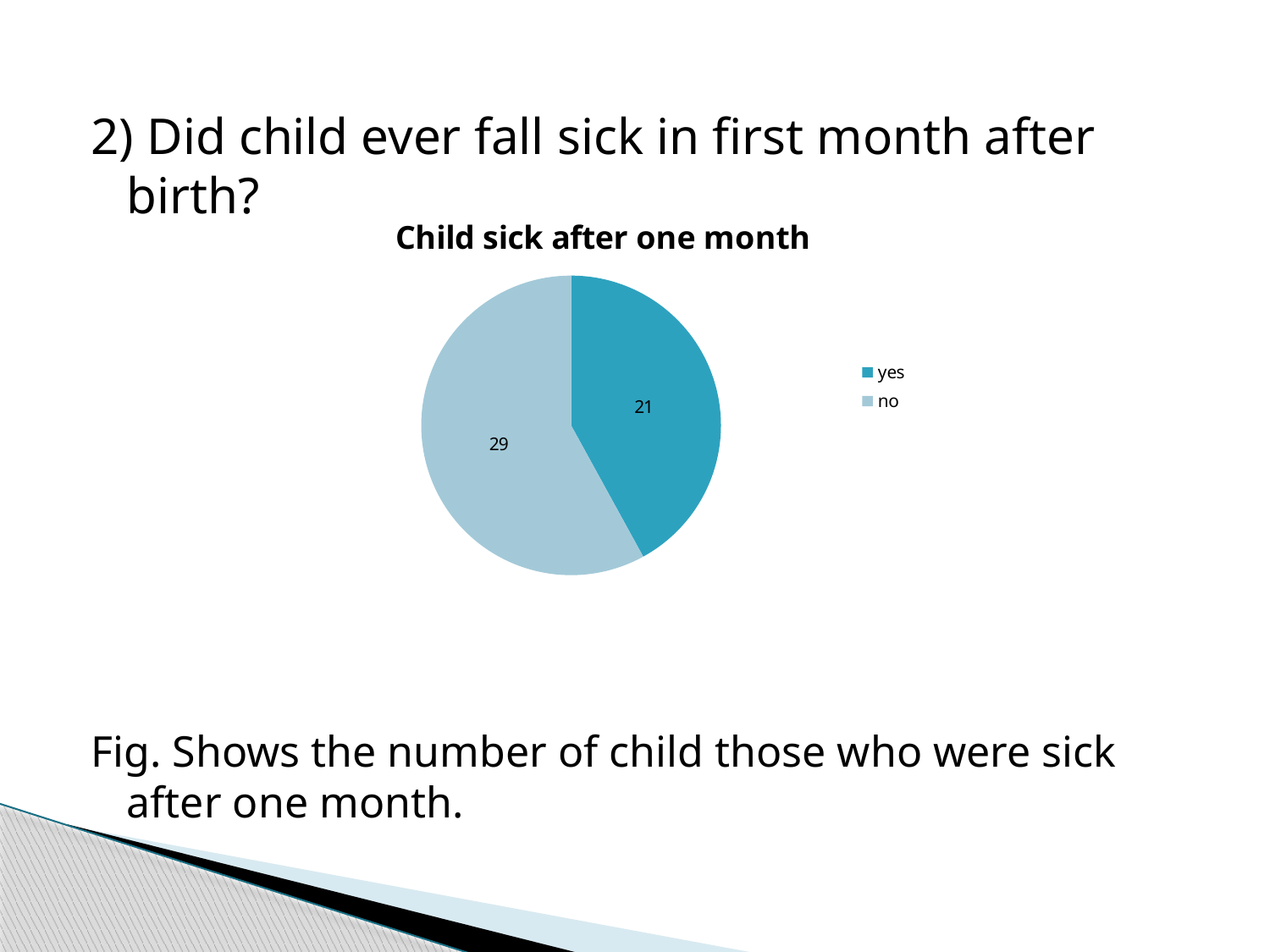
What is the title of the chart? Child sick after one month Which slice is the smallest? yes How many entries does the legend list? 2 What share of the pie does the "no" slice represent? 58% What is the difference between the "no" and "yes" values? 8 What is the total of all slices in the pie chart? 50 What is the value for the "no" slice? 29 How many slices does the pie chart have? 2 Which is larger, the "yes" slice or the "no" slice? no What type of chart is shown on the slide? pie chart What is the value for the "yes" slice? 21 Which slice is the largest? no